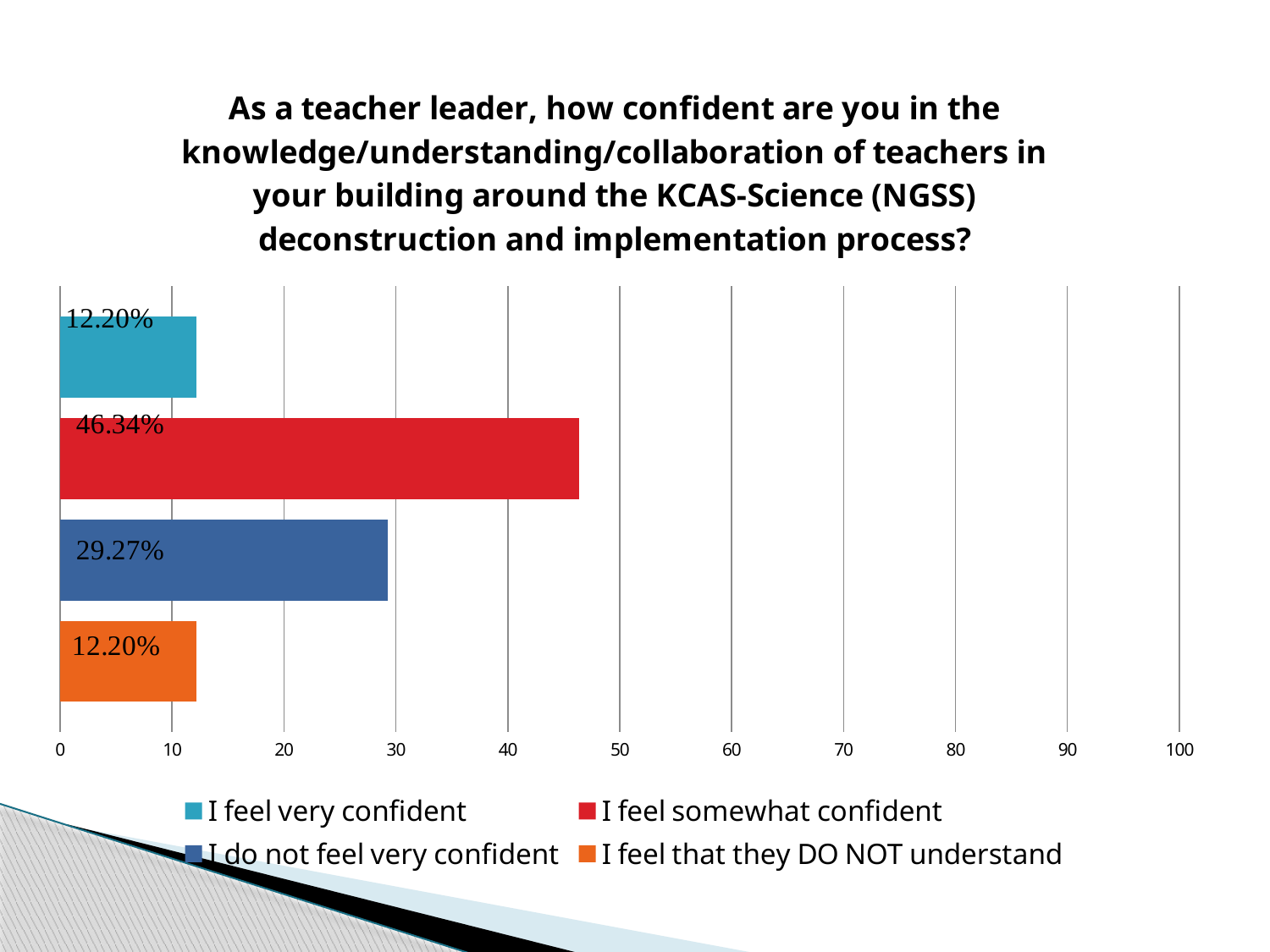
What percentage of respondents said "I feel somewhat confident"? 46.34% What is the difference between "I feel somewhat confident" and "I do not feel very confident"? 17.07% What value is shown for "I do not feel very confident"? 29.27% What is the difference between "I do not feel very confident" and "I feel very confident"? 17.07% What value is shown for "I feel that they DO NOT understand"? 12.20% Is the value for "I feel somewhat confident" greater or less than 50? less What kind of chart is shown on the slide? bar chart Which is larger: "I feel somewhat confident" or "I do not feel very confident"? I feel somewhat confident How many series does the legend list? 4 What is the highest value shown on the horizontal axis? 100 Which response has the highest value? I feel somewhat confident What value is shown for "I feel very confident"? 12.20%